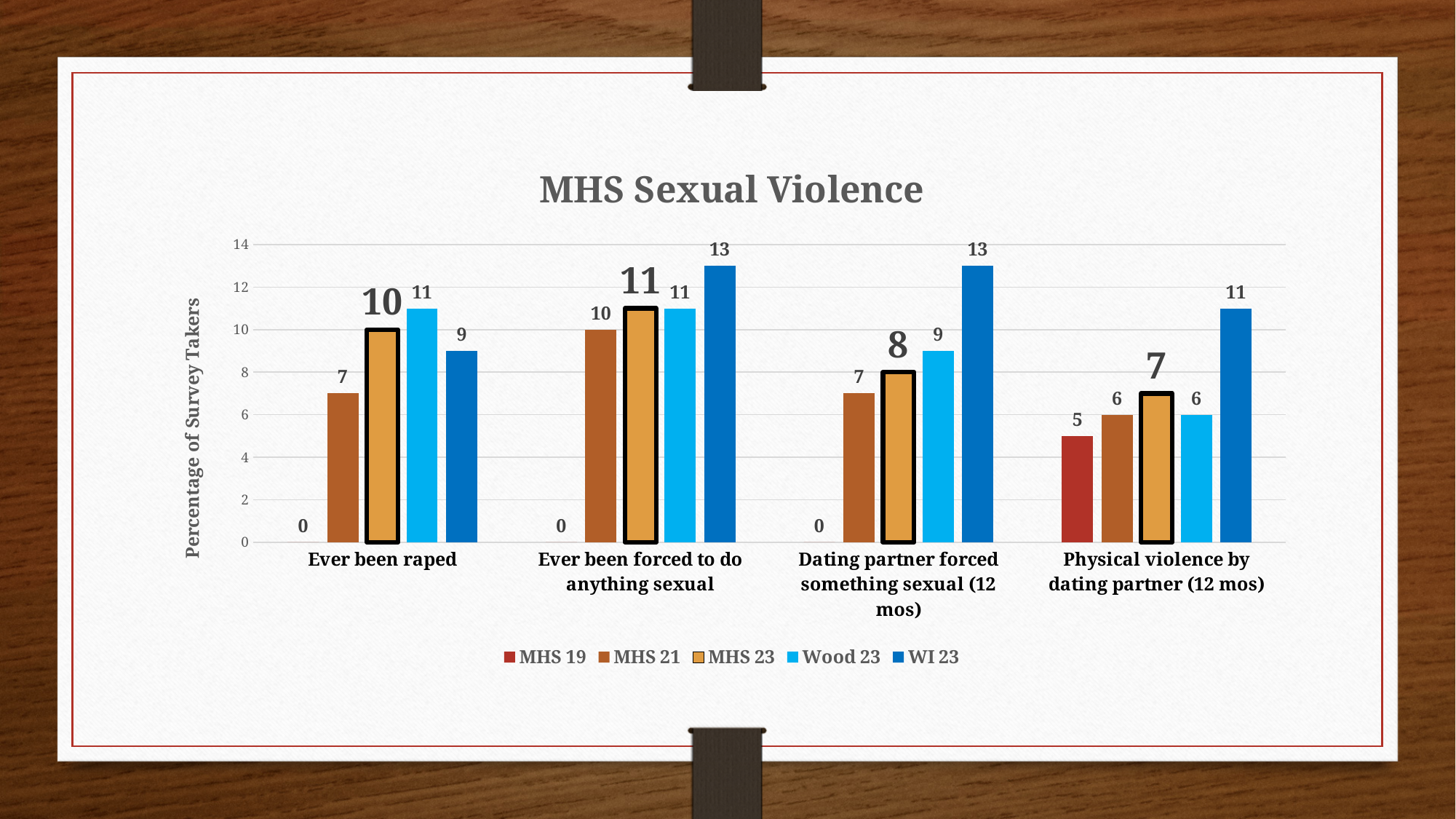
How many series does the legend list? 5 What is the title of the chart? MHS Sexual Violence In the 'Ever been forced to do anything sexual' category, which is larger: the MHS 21 value or the WI 23 value? WI 23 What is the value for MHS 19 in the 'Physical violence by dating partner (12 mos)' category? 5 What is the value for MHS 23 in the 'Ever been raped' category? 10 Which series has the highest value in the 'Dating partner forced something sexual (12 mos)' category? WI 23 What kind of chart is shown on the slide? Bar chart Which series has the lowest value in the 'Physical violence by dating partner (12 mos)' category? MHS 19 What is the value for WI 23 in the 'Ever been forced to do anything sexual' category? 13 How many categories are shown on the x axis? 4 What is the difference between the WI 23 and MHS 21 values in the 'Ever been raped' category? 2 What is the value for Wood 23 in the 'Dating partner forced something sexual (12 mos)' category? 9